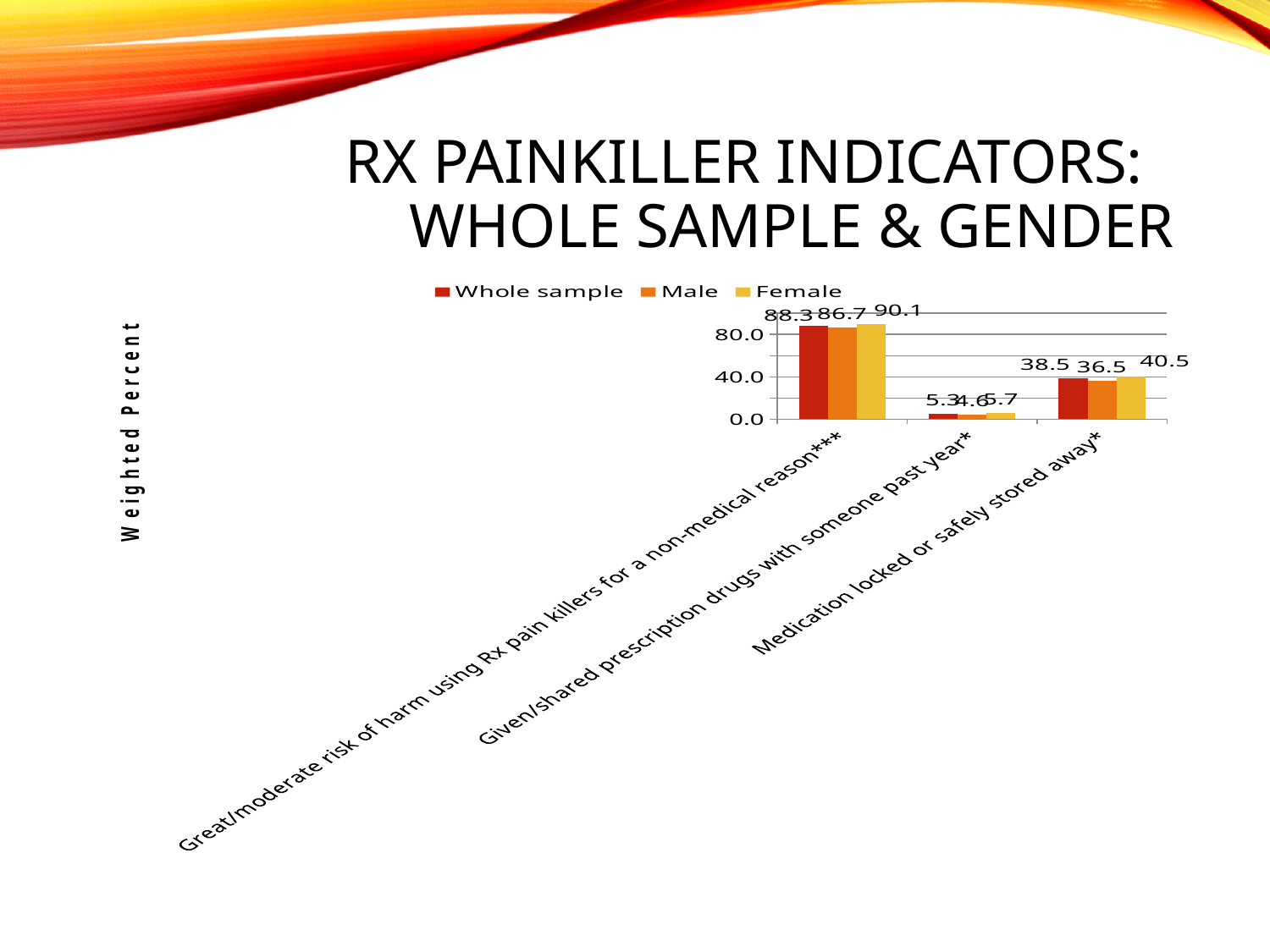
Which category has the highest Whole sample value? Great/moderate risk of harm using Rx pain killers for a non-medical reason*** What is the Male value for "Medication locked or safely stored away*"? 36.5 How many categories are shown on the x axis? 3 What is the difference between the Female and Male values for "Medication locked or safely stored away*"? 4.0 What is the Female value for "Medication locked or safely stored away*"? 40.5 What is the Female value for "Great/moderate risk of harm using Rx pain killers for a non-medical reason***"? 90.1 How many series does the legend list? 3 Which category has the lowest Female value? Given/shared prescription drugs with someone past year* What is the Whole sample value for "Great/moderate risk of harm using Rx pain killers for a non-medical reason***"? 88.3 For "Great/moderate risk of harm using Rx pain killers for a non-medical reason***", which is larger: the Male value or the Female value? Female Is the Whole sample value for "Given/shared prescription drugs with someone past year*" greater or less than 40.0? less What kind of chart is shown on the slide? bar chart